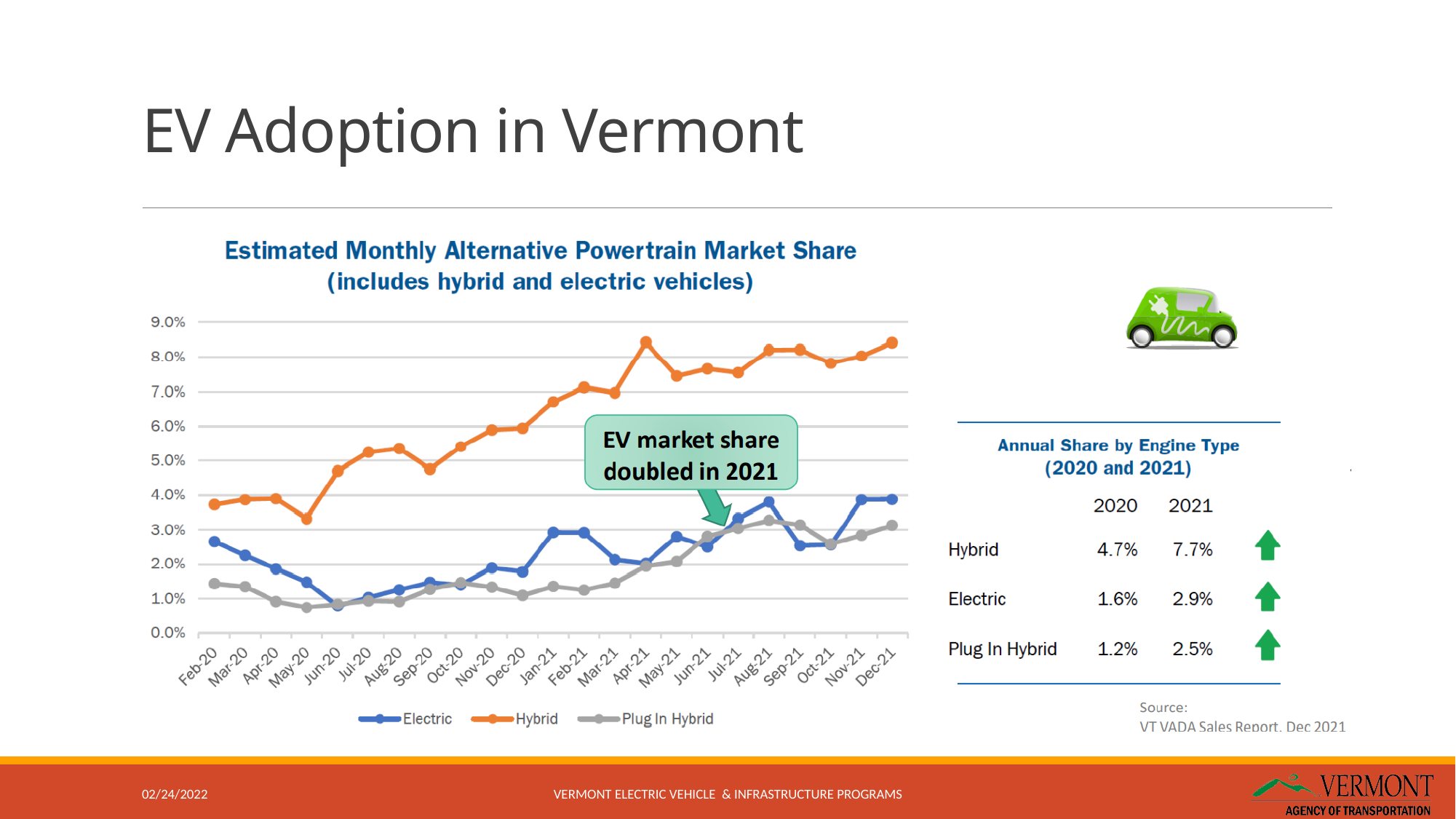
Which colour is used for the Plug In Hybrid series in the chart? Grey What kind of chart is shown on the slide? Line chart Does the Hybrid series generally rise or fall from Feb-20 to Dec-21? Rise Which series has the highest market share in Dec-21? Hybrid Is the Hybrid value for May-20 greater or less than 4.0%? less Which is larger in Apr-21, the Hybrid value or the Electric value? Hybrid In which month does the Hybrid series reach its lowest value? May-20 How many months are plotted along the x axis of the chart? 23 Is the Hybrid value for Apr-21 greater or less than 8.0%? greater How many series does the chart's legend list? 3 In which month does the Electric series reach its lowest value? Jun-20 Is the Electric value for Aug-21 greater or less than 3.0%? greater